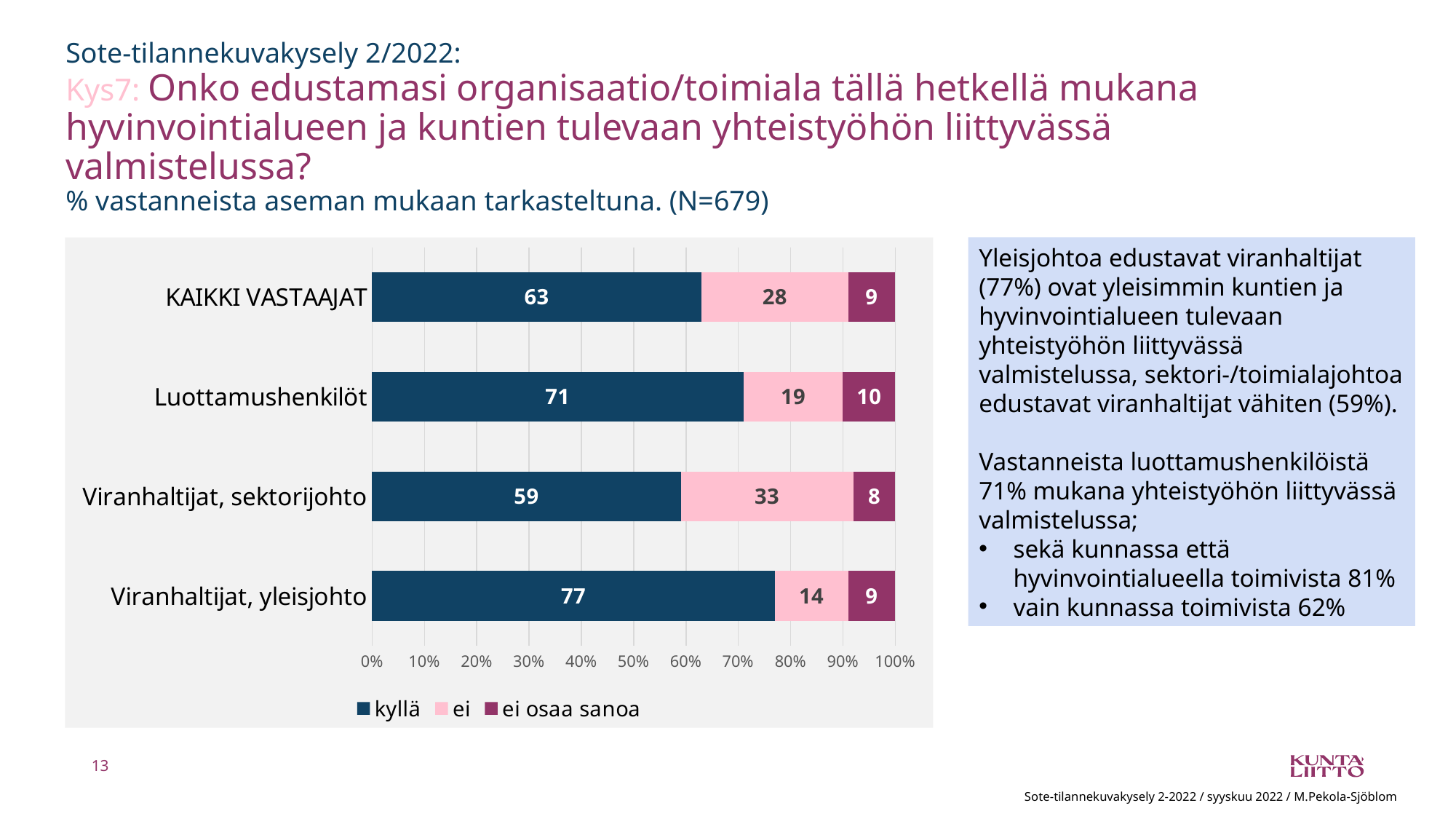
What is the 'ei' value for Viranhaltijat, sektorijohto? 33 How many categories are shown on the chart? 4 Which is larger: the 'ei' value for Luottamushenkilöt or for Viranhaltijat, yleisjohto? Luottamushenkilöt What is the 'ei osaa sanoa' value for Luottamushenkilöt? 10 What is the total of the stacked bar for Luottamushenkilöt? 100 How many series does the legend list? 3 Which legend entry is shown in pink? ei What kind of chart is shown on the slide? Stacked bar chart Which category has the lowest 'kyllä' value? Viranhaltijat, sektorijohto What is the 'kyllä' value for KAIKKI VASTAAJAT? 63 Which category has the highest 'kyllä' value? Viranhaltijat, yleisjohto What is the difference between the 'kyllä' values for Viranhaltijat, yleisjohto and Viranhaltijat, sektorijohto? 18